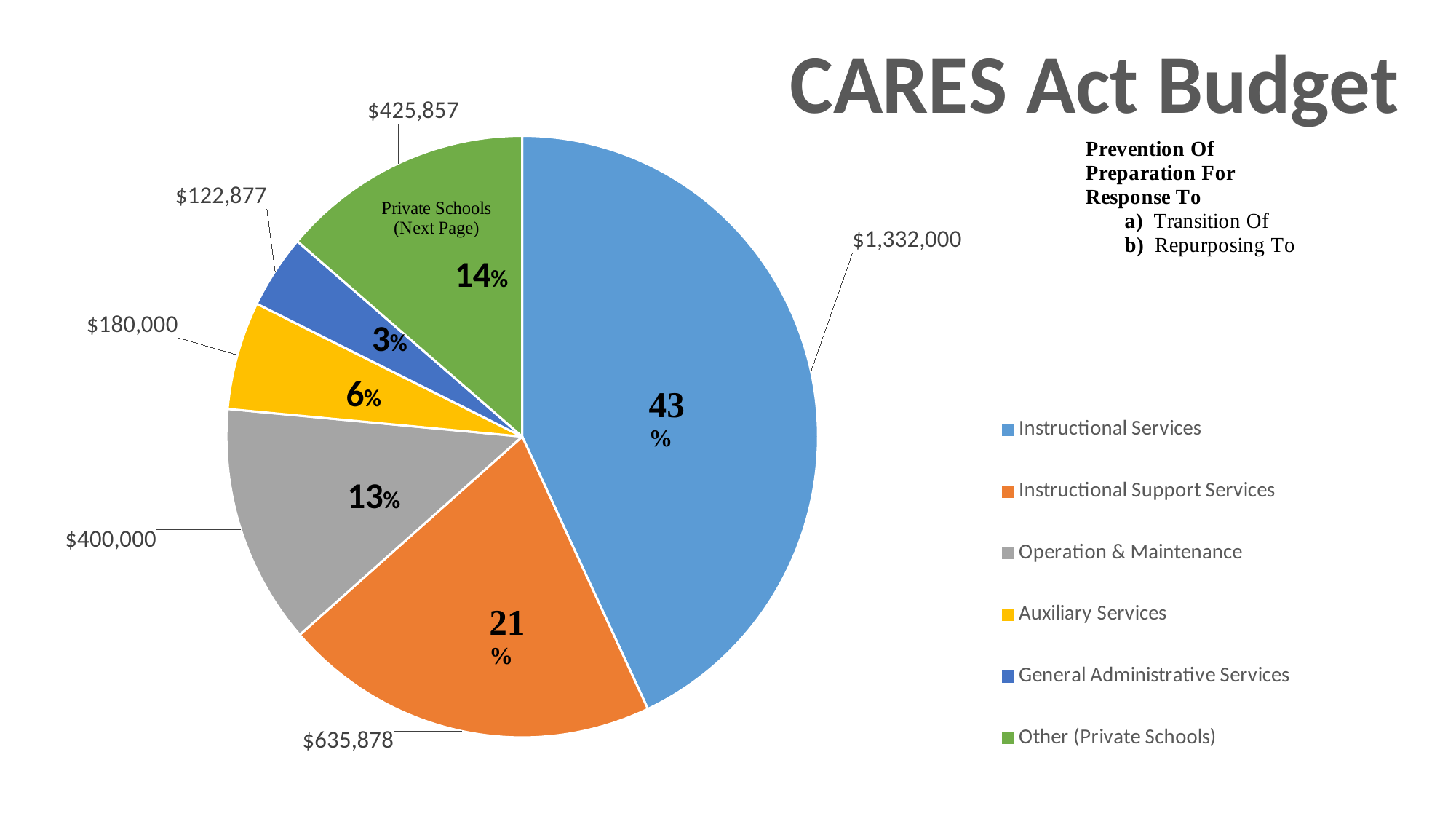
What type of chart is shown on the slide? Pie chart What is the dollar value for Instructional Support Services? $635,878 What is the dollar value for General Administrative Services? $122,877 Which category has the smallest share of the CARES Act Budget? General Administrative Services What is the difference in dollars between Operation & Maintenance and Auxiliary Services? $220,000 Which category has the largest share of the CARES Act Budget? Instructional Services What is the dollar value for Instructional Services? $1,332,000 How many categories does the legend list? 6 What is the dollar value for Operation & Maintenance? $400,000 What percentage share of the budget goes to Other (Private Schools)? 14% What percentage share of the budget goes to Auxiliary Services? 6% Which is larger, the value for Other (Private Schools) or the value for Operation & Maintenance? Other (Private Schools)